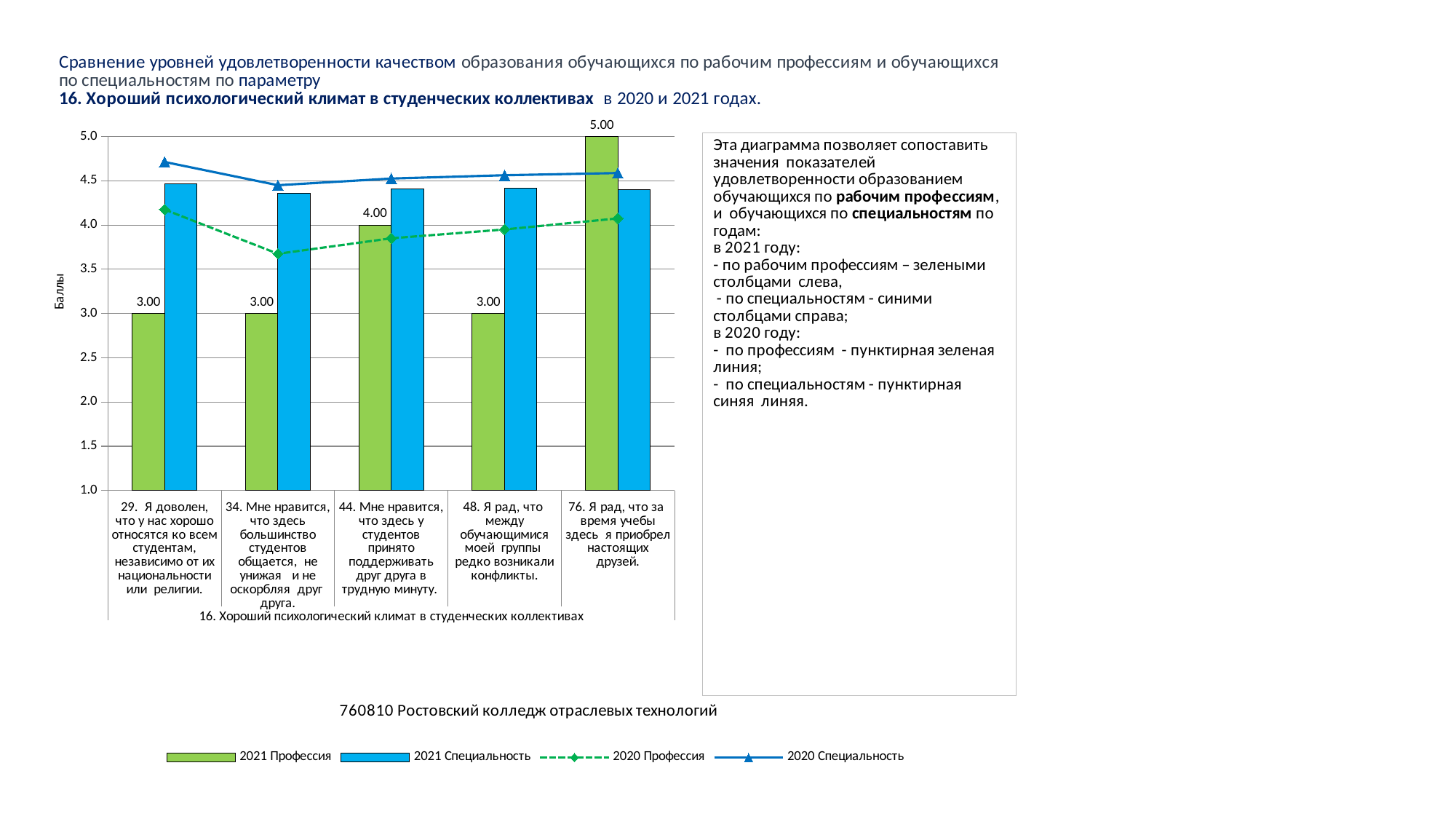
Is the 2021 Специальность value for category 29 greater or less than 4.0? greater Is the 2020 Профессия value for category 34 greater or less than 4.0? less Which category has the highest value in the 2021 Профессия series? 76. Я рад, что за время учебы здесь я приобрел настоящих друзей. What is the value of the 2021 Профессия series for category 44 (Мне нравится, что здесь у студентов принято поддерживать друг друга в трудную минуту)? 4.00 How many categories are shown on the x axis of the chart? 5 What is the difference between the 2021 Профессия values for category 76 and category 29? 2.00 For category 29, which is larger: the 2021 Профессия value or the 2021 Специальность value? 2021 Специальность What is the label of the vertical axis of the chart? Баллы Which category has the lowest value in the 2020 Профессия series? 34. Мне нравится, что здесь большинство студентов общается, не унижая и не оскорбляя друг друга. What is the value of the 2021 Профессия series for category 76 (Я рад, что за время учебы здесь я приобрел настоящих друзей)? 5.00 How many series does the legend list? 4 What kind of chart is shown on the slide? Combined bar and line chart